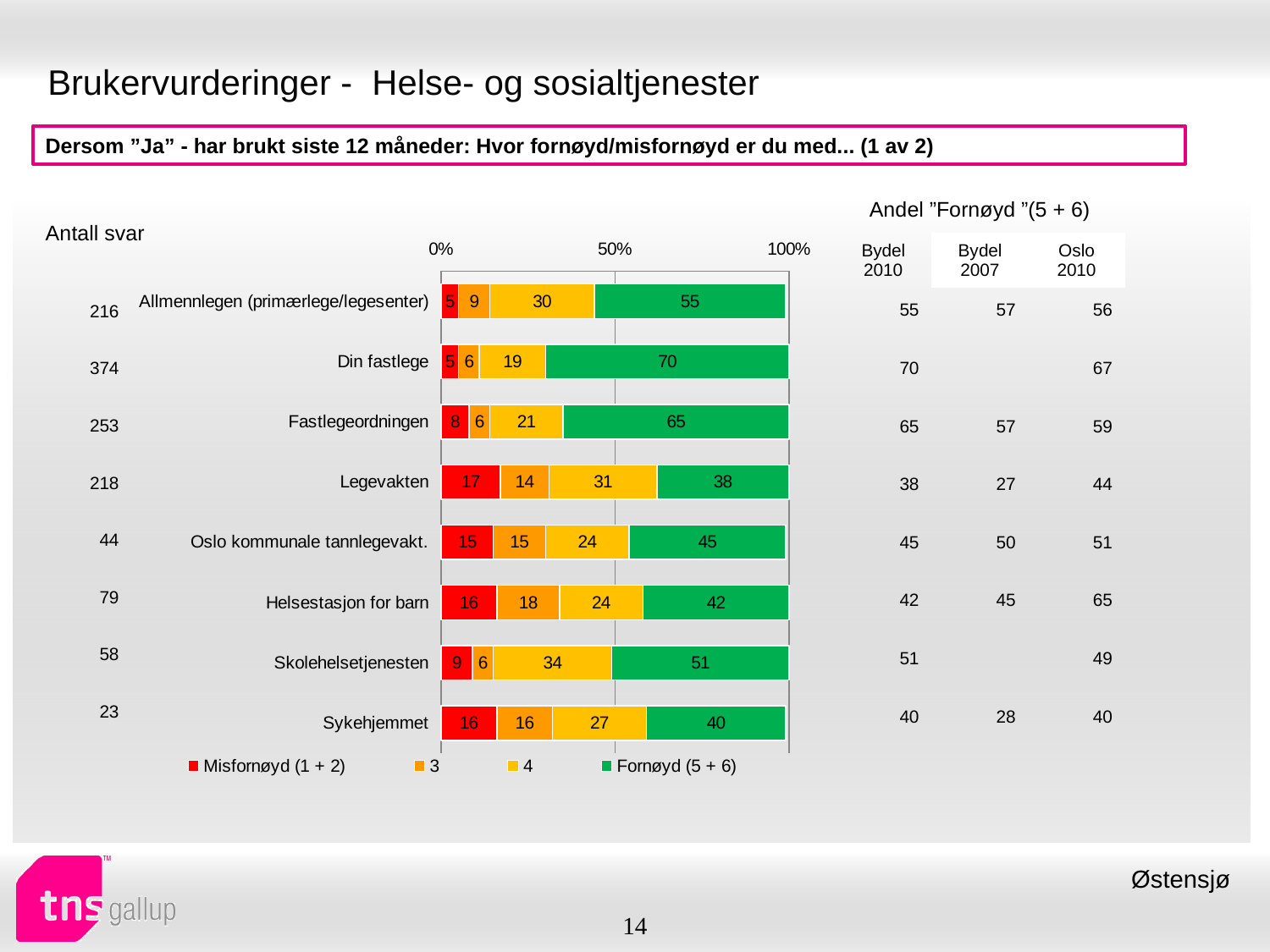
What kind of chart is shown on the slide? Stacked bar chart How many series does the legend list? 4 What is the value of the Fornøyd (5 + 6) segment for Din fastlege? 70 Which has a larger Fornøyd (5 + 6) value, Fastlegeordningen or Allmennlegen (primærlege/legesenter)? Fastlegeordningen What is the value of the '4' segment for Skolehelsetjenesten? 34 What is the first entry in the chart legend? Misfornøyd (1 + 2) What is the difference between the Fornøyd (5 + 6) values for Din fastlege and Legevakten? 32 What is the total of the stacked bar for Legevakten? 100 Which category has the highest Fornøyd (5 + 6) value? Din fastlege How many categories are shown in the bar chart? 8 What is the value of the Misfornøyd (1 + 2) segment for Legevakten? 17 Which category has the lowest Fornøyd (5 + 6) value? Legevakten